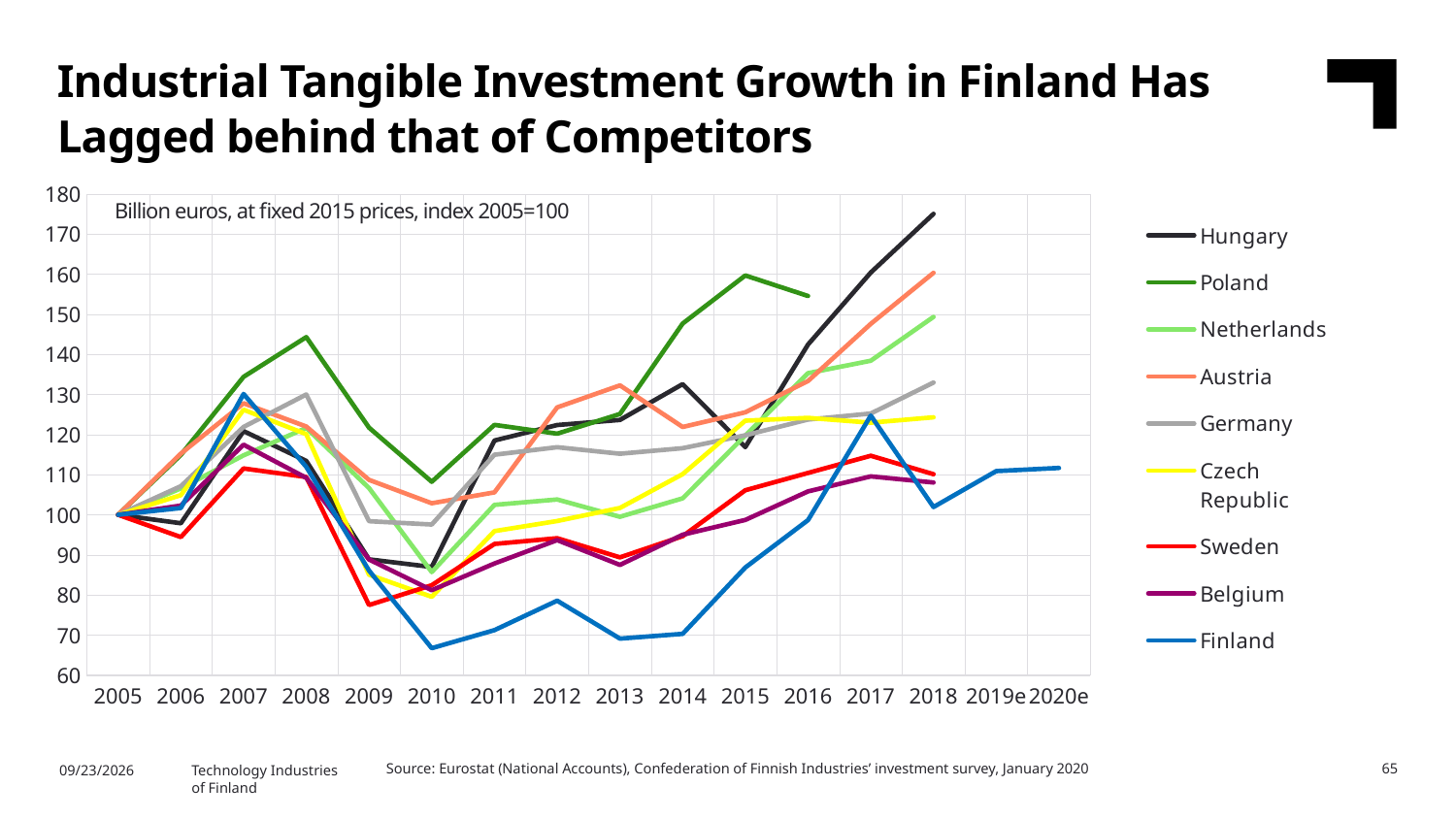
Is the value for Poland in 2008 greater or less than 140? greater Which country has the lowest value in 2010? Finland How many series does the legend list? 9 Is the value for Hungary in 2018 greater or less than 170? greater Is the value for Sweden in 2009 greater or less than 80? less How many years are shown along the x axis? 16 What is the index value for Finland in 2005? 100 What kind of chart is shown on the slide? line chart Which is larger in 2014, the value for Poland or the value for Sweden? Poland Which country has the highest value in 2018? Hungary Does the value for Hungary rise or fall from 2010 to 2018? rise